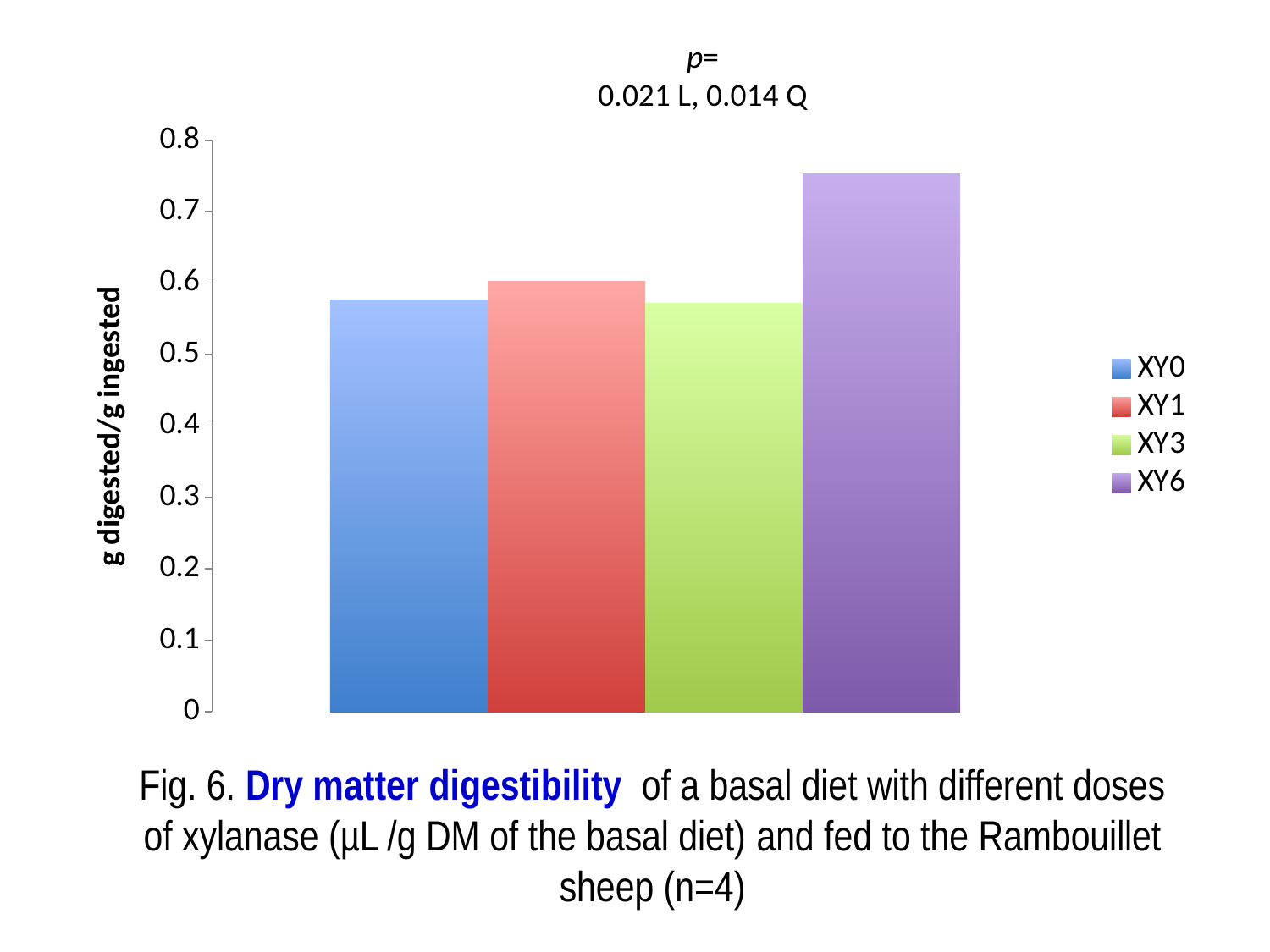
Which is larger, the value for XY6 or the value for XY0? XY6 Which is larger, the value for XY6 or the value for XY1? XY6 Is the value for XY0 greater or less than 0.5? greater What colour is the bar for XY6? purple Which series has the highest dry matter digestibility? XY6 Is the value for XY3 greater or less than 0.6? less Is the value for XY1 greater or less than 0.7? less How many series does the legend list? 4 What is the label on the y axis? g digested/g ingested What kind of chart is shown on the slide? bar chart